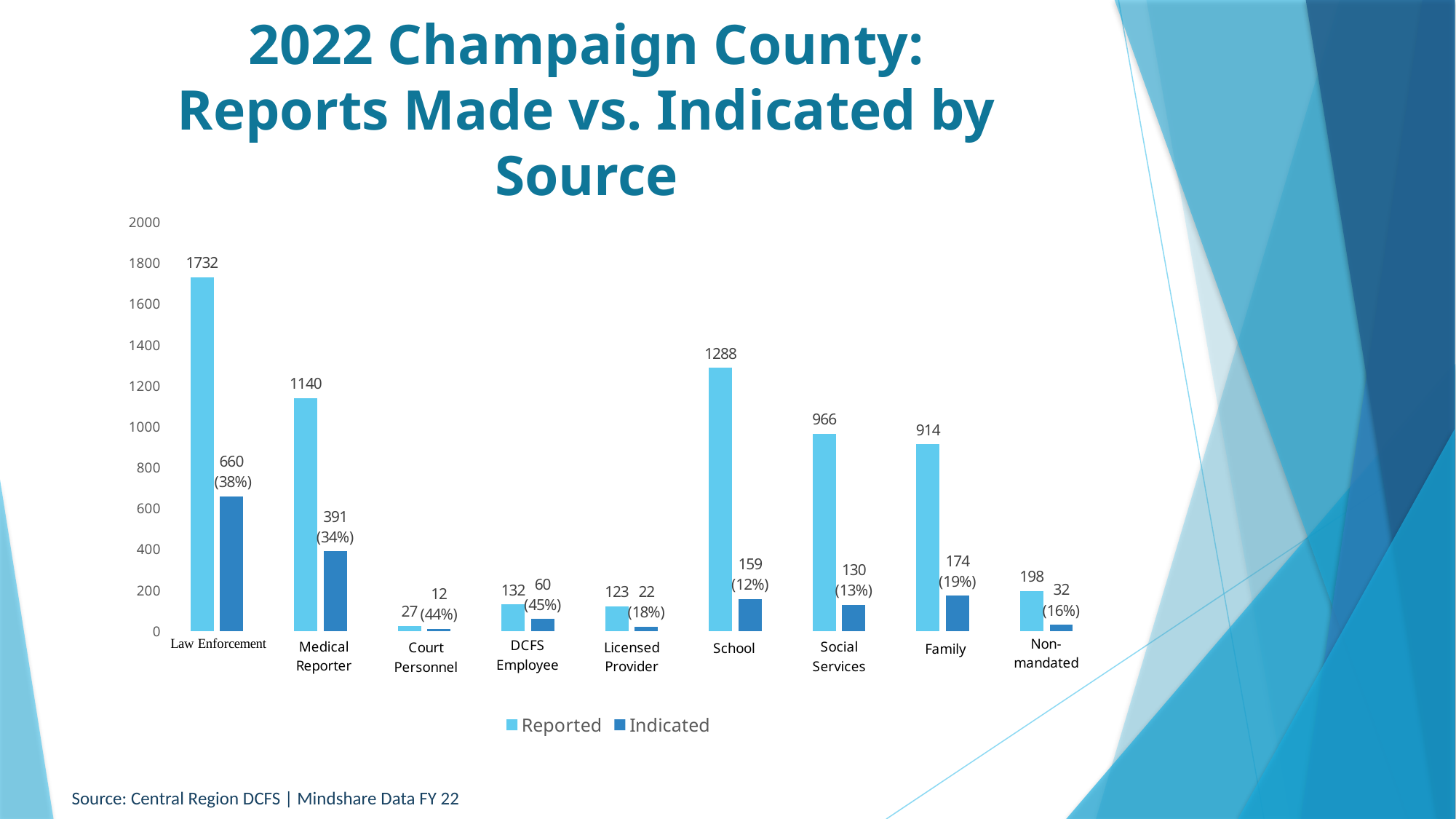
How many source categories are shown on the x axis? 9 How many series does the legend list? 2 What is the difference between the Reported and Indicated values for Social Services? 836 What is the Indicated value for Medical Reporter? 391 Is the Reported value for Medical Reporter greater or less than 1000? greater What percentage is shown next to the Indicated value for Family? 19% Which source has the lowest Indicated value? Court Personnel What is the Reported value for School? 1288 What kind of chart is shown on the slide? Bar chart What is the Reported value for Law Enforcement? 1732 Which is larger, the Reported value for Family or the Reported value for Social Services? Social Services Which source has the highest Reported value? Law Enforcement